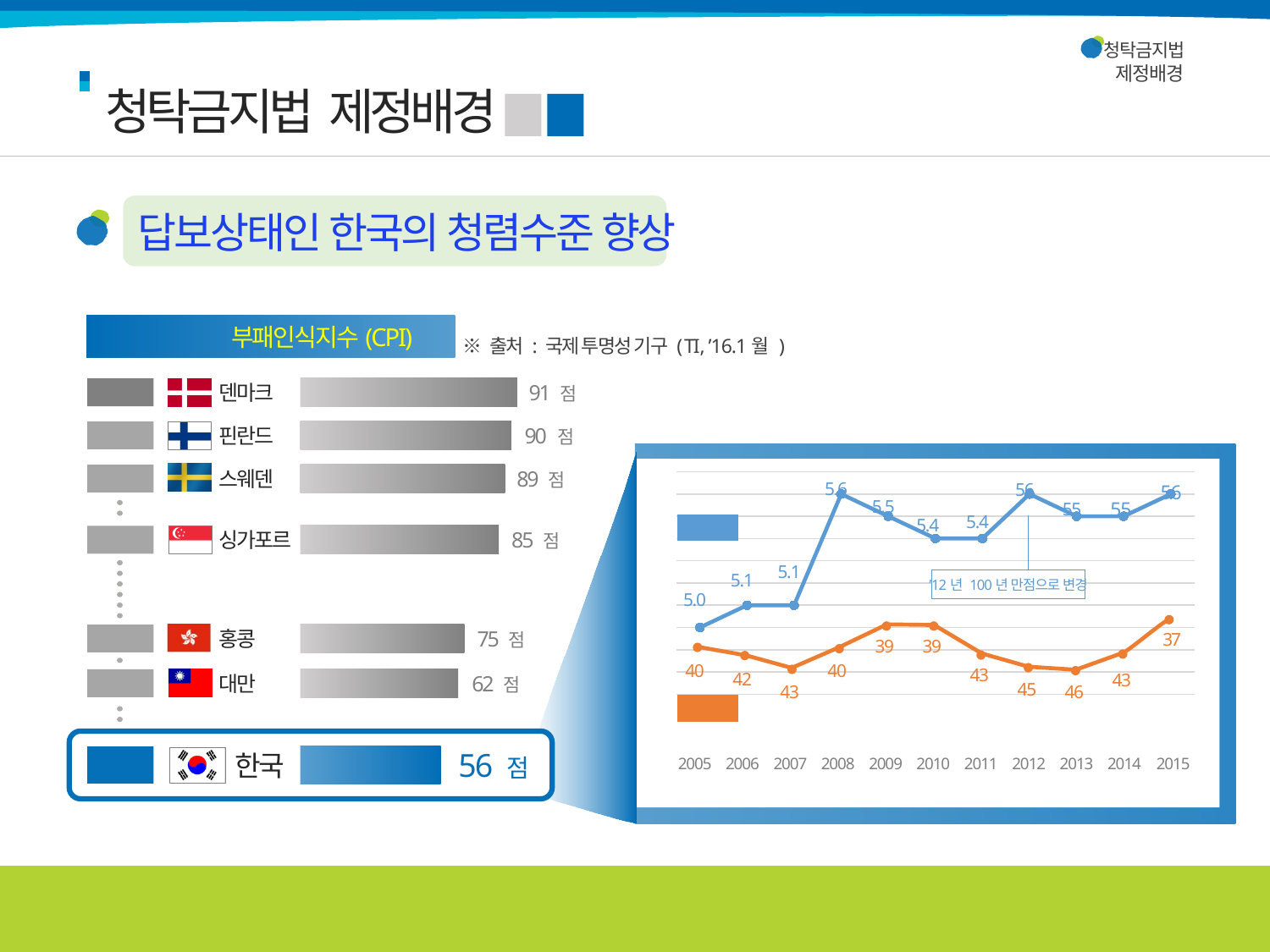
In the bar chart 부패인식지수 (CPI), how many countries are shown? 7 In the line chart on the right, how many series are plotted? 2 In the bar chart 부패인식지수 (CPI), which country has the lowest score? 한국 In the line chart on the right, what is the value of the blue line for 2008? 5.6 In the bar chart 부패인식지수 (CPI), which has the higher score, 홍콩 or 대만? 홍콩 In the line chart on the right, what is the value of the orange line for 2015? 37 In the bar chart 부패인식지수 (CPI), which country has the highest score? 덴마크 What kind of chart is the chart on the right side of the slide? Line chart In the bar chart 부패인식지수 (CPI), what is the value for 덴마크? 91 점 In the line chart on the right, how many years are shown on the x axis? 11 In the bar chart 부패인식지수 (CPI), what is the difference between the scores of 덴마크 and 한국? 35 점 In the bar chart 부패인식지수 (CPI), what is the value for 한국? 56 점